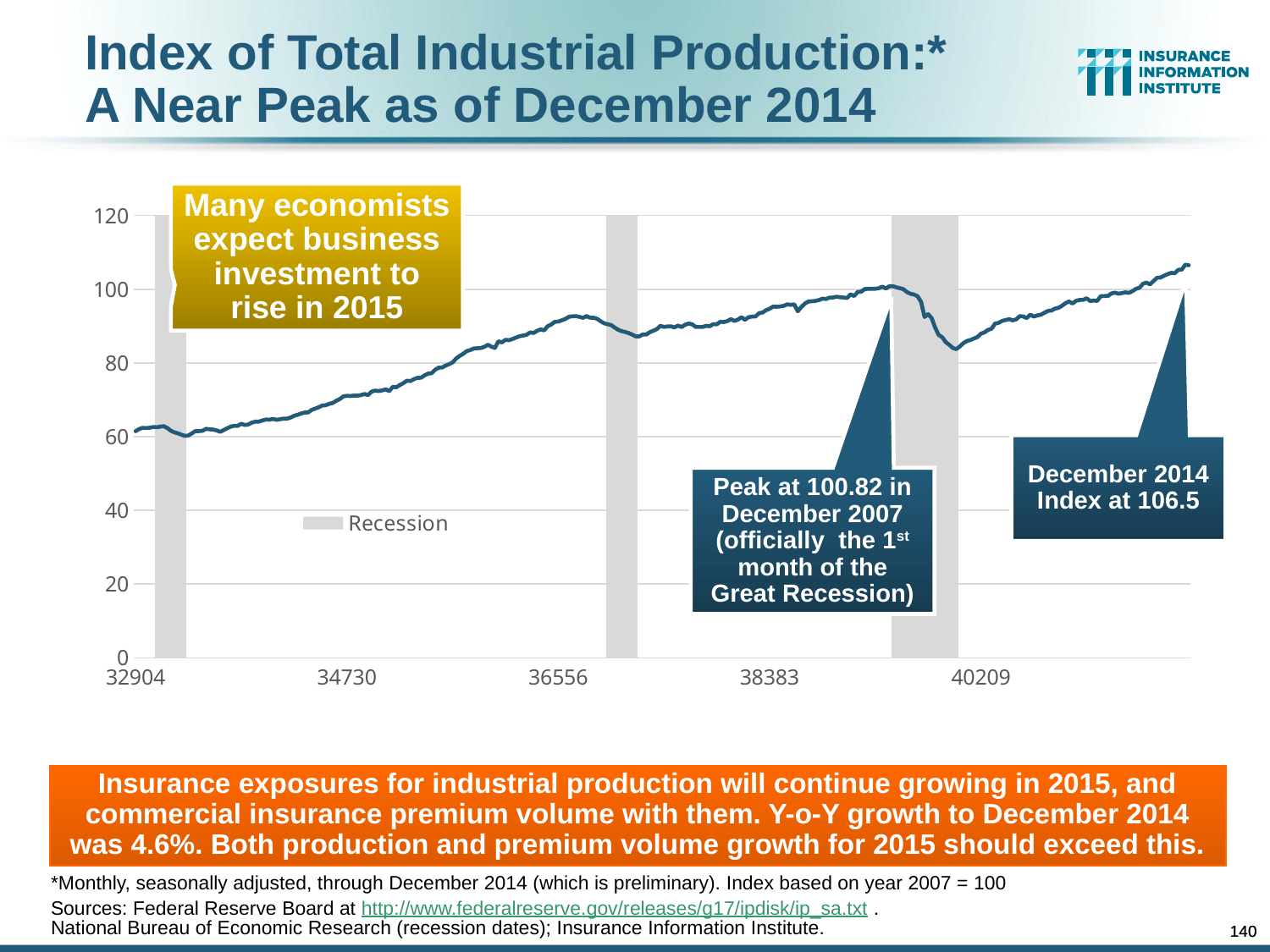
What was the Index of Total Industrial Production in December 2014? 106.5 What does the grey shading in the chart represent, according to the legend? Recession By how much does the December 2014 index value exceed the December 2007 peak? 5.68 Is the index value at the x-axis label 36556 greater or less than 80? greater Does the index generally rise or fall from the left of the chart to the right? rise What was the peak value of the index in December 2007? 100.82 Is the index value at the x-axis label 40209 greater or less than 100? less What kind of chart is shown on the slide? line chart How many shaded recession periods are shown on the chart? 3 Is the index value at the x-axis label 32904 greater or less than 80? less What is the highest value shown on the y-axis? 120 Which is higher: the index in December 2007 or in December 2014? December 2014